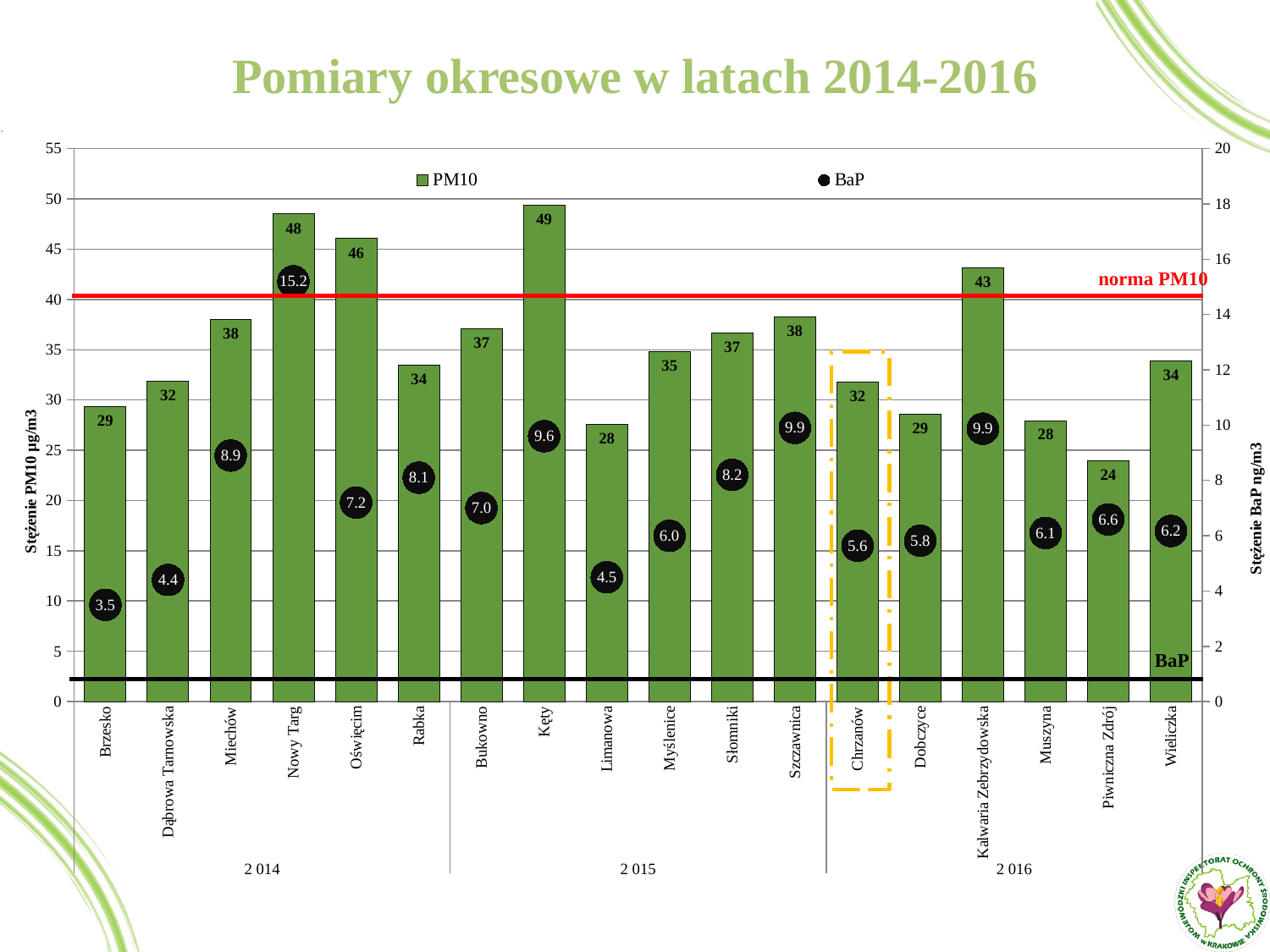
What is the BaP value for Kęty? 9.6 What is the BaP value for Chrzanów? 5.6 What is the PM10 value for Nowy Targ? 48 How many locations are shown on the x axis? 18 Which has a higher PM10 value, Miechów or Rabka? Miechów What is the difference between the PM10 values for Kęty and Limanowa? 21 What is the title of the slide? Pomiary okresowe w latach 2014-2016 How many series does the legend list? 2 Which location has the highest PM10 value? Kęty Which location has the lowest BaP value? Brzesko Which location has the highest BaP value? Nowy Targ Which location has the lowest PM10 value? Piwniczna Zdrój